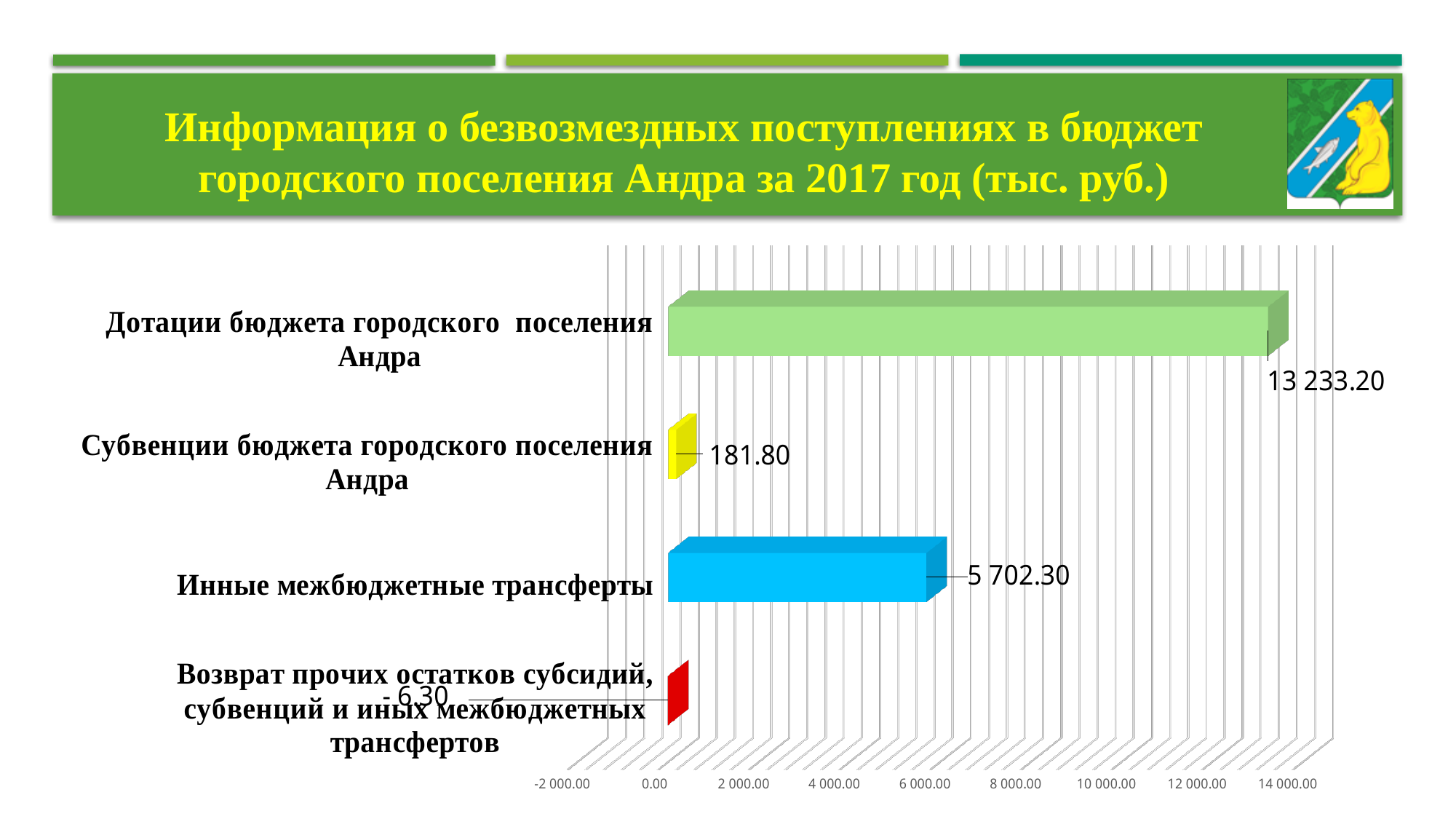
Which category has the lowest value? Возврат прочих остатков субсидий, субвенций и иных межбюджетных трансфертов What is the value for Инные межбюджетные трансферты? 5 702.30 Is the value for Дотации бюджета городского поселения Андра greater or less than 12 000.00? greater Which category has the highest value? Дотации бюджета городского поселения Андра What is the value for Дотации бюджета городского поселения Андра? 13 233.20 What kind of chart is shown on the slide? bar chart What is the difference between the values for Дотации бюджета городского поселения Андра and Инные межбюджетные трансферты? 7 530.90 How many categories are shown in the chart? 4 What is the value for Возврат прочих остатков субсидий, субвенций и иных межбюджетных трансфертов? -6.30 What colour is the bar for Дотации бюджета городского поселения Андра? green Which is larger: the value for Субвенции бюджета городского поселения Андра or the value for Инные межбюджетные трансферты? Инные межбюджетные трансферты What is the value for Субвенции бюджета городского поселения Андра? 181.80